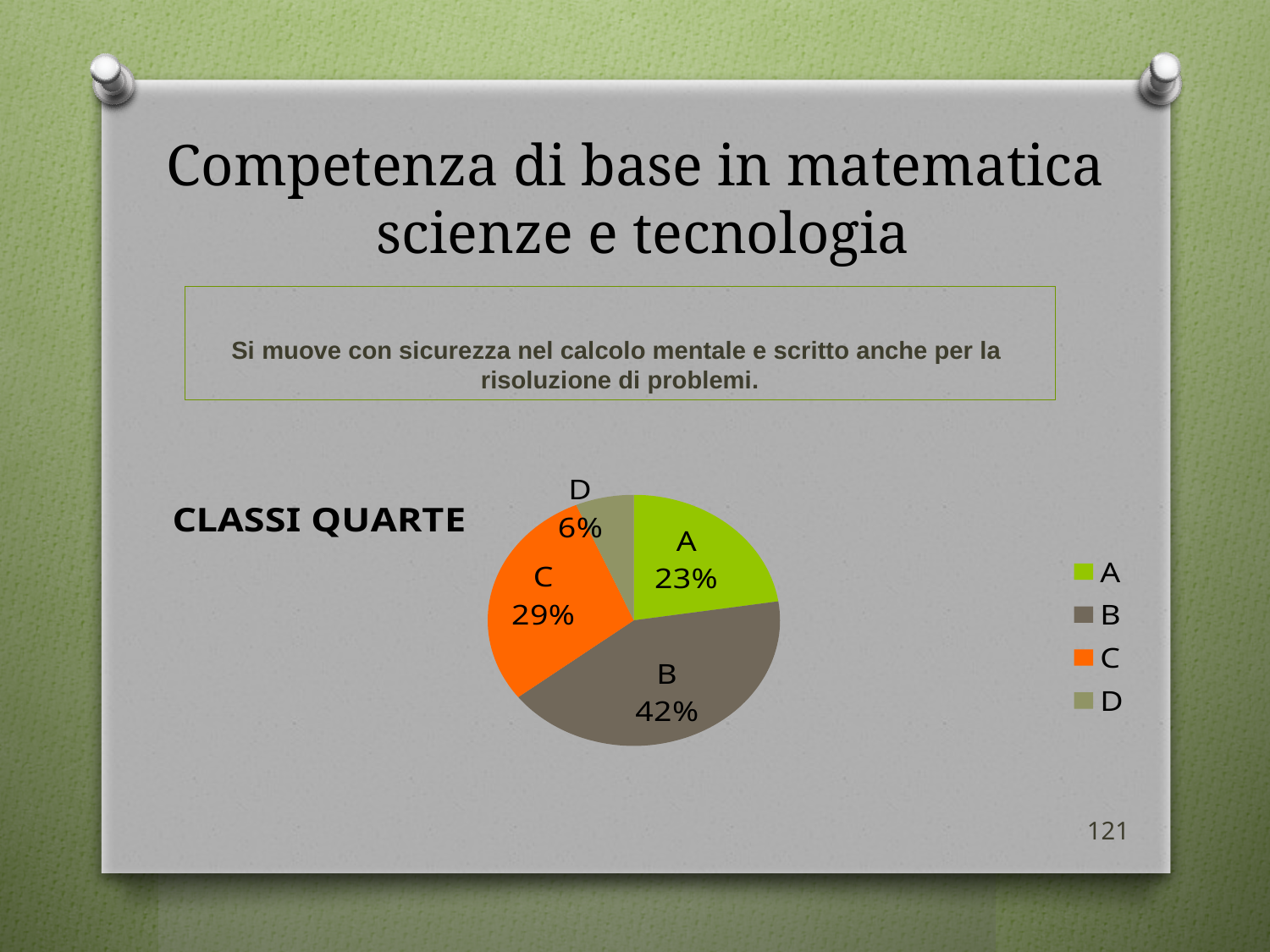
What percentage does slice D represent in the pie chart? 6% How many entries does the legend list? 4 What percentage does slice B represent in the pie chart? 42% What percentage does slice A represent in the pie chart? 23% Which is larger, slice A or slice C? C What percentage does slice C represent in the pie chart? 29% What kind of chart is shown on the slide? pie chart What colour is slice C in the pie chart? orange Which slice is the smallest in the pie chart? D Which slice is the largest in the pie chart? B How many slices does the pie chart have? 4 What is the difference in percentage points between slice B and slice C? 13